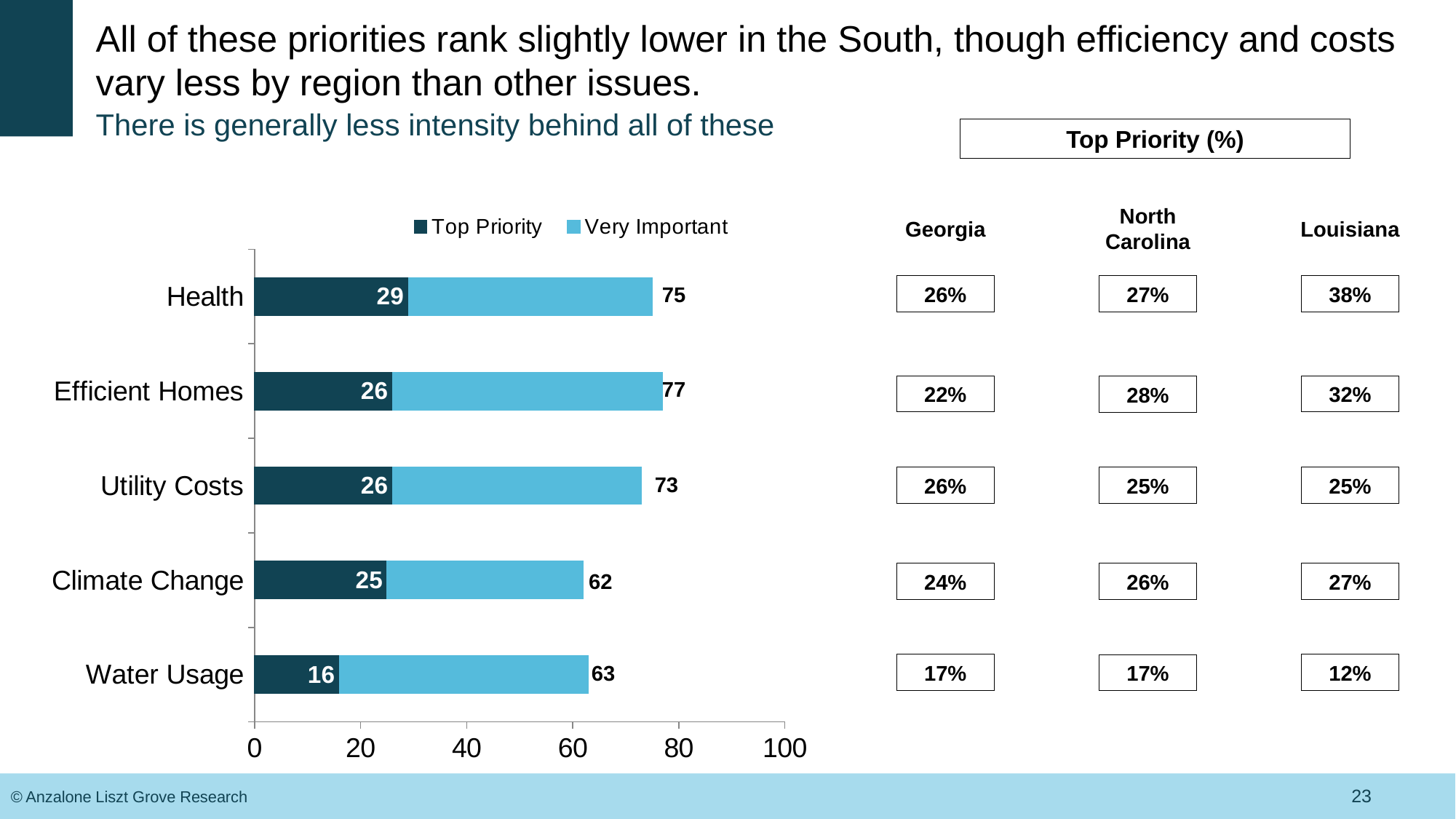
How many categories are plotted in the bar chart? 5 What is the Top Priority value for Water Usage? 16 How many series does the chart legend list? 2 Which has the larger total bar, Efficient Homes or Utility Costs? Efficient Homes What kind of chart is shown on the slide? bar chart Which category has the lowest Top Priority value? Water Usage Which category has the highest Top Priority value? Health What is the total labelled at the end of the Efficient Homes bar? 77 What is the total labelled at the end of the Climate Change bar? 62 Which series is shown in the darker colour in the chart legend? Top Priority What is the Top Priority value for Health? 29 What is the difference between the Top Priority values for Health and Water Usage? 13